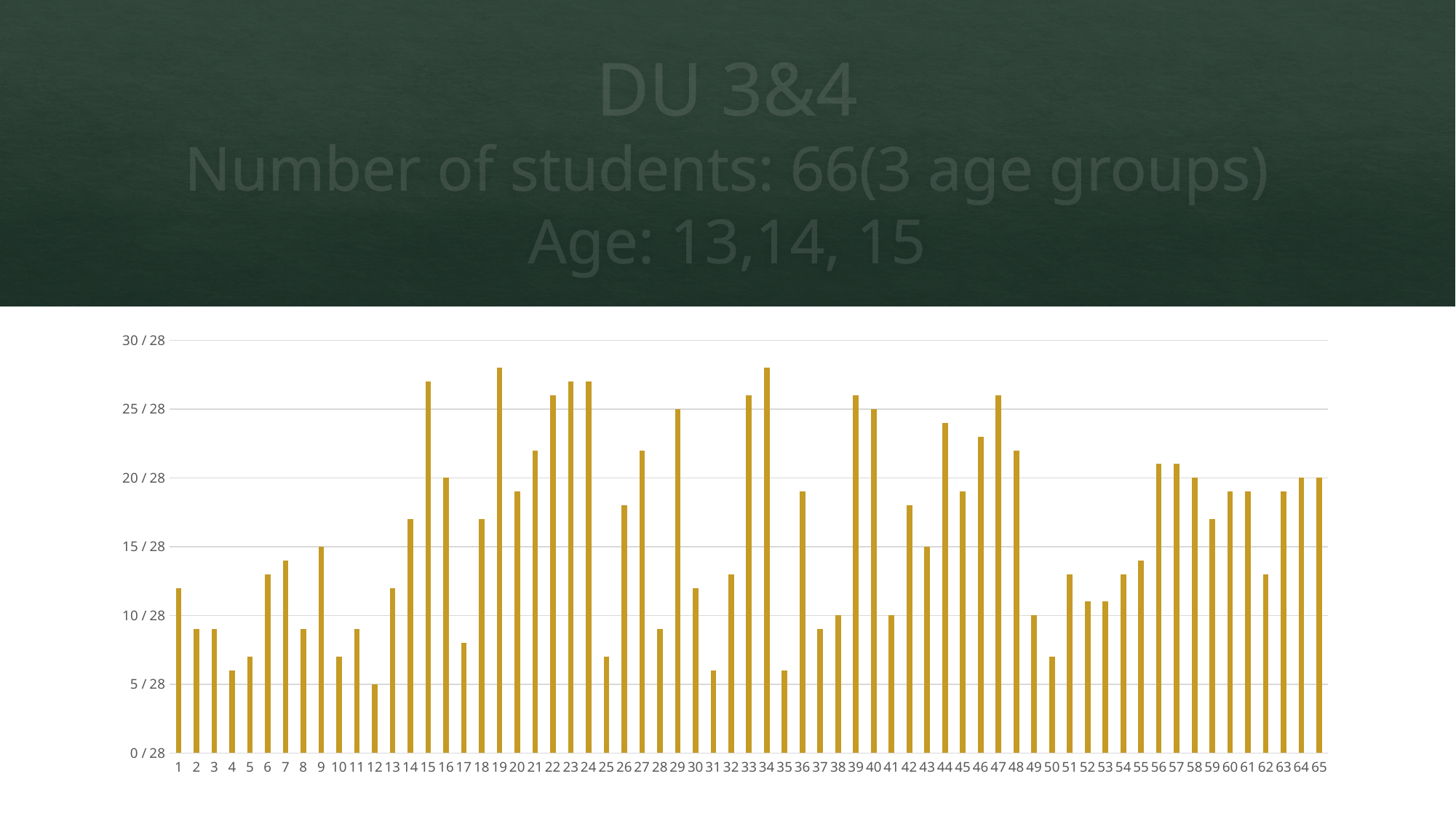
How many categories (bars) are plotted along the x axis? 65 Which has the larger value, category 17 or category 15? 15 Which has the larger value, category 19 or category 12? 19 Is the value for category 44 greater or less than 20 / 28? greater Is the value for category 50 greater or less than 10 / 28? less Is the value for category 15 greater or less than 25 / 28? greater What is the highest tick label shown on the y axis? 30 / 28 What kind of chart is shown on the slide? bar chart Which has the larger value, category 34 or category 35? 34